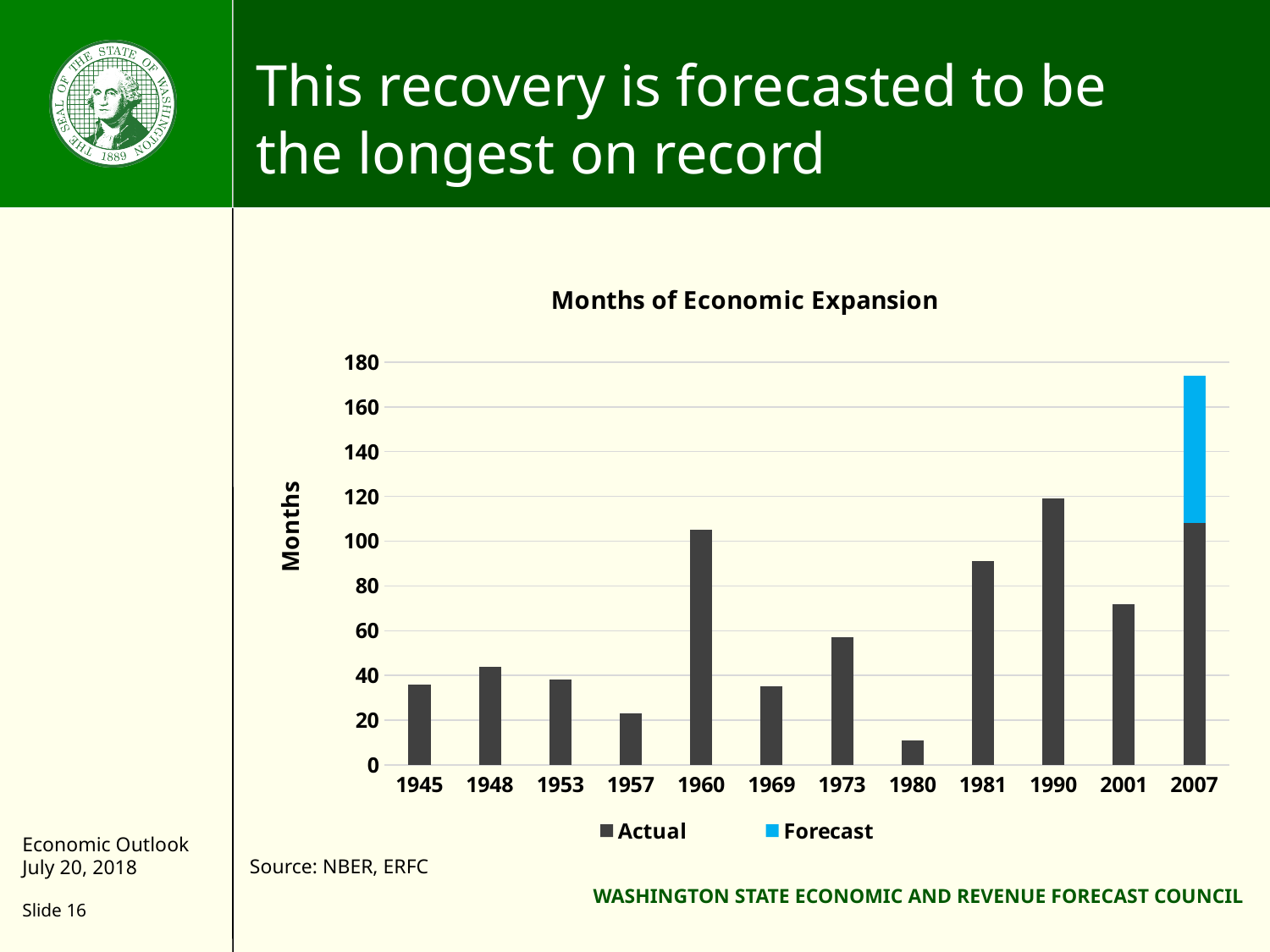
What type of chart is shown on the slide? bar chart Which expansion has the shortest bar? 1980 Is the value for 1980 greater or less than 20 months? less How many expansion start years are shown along the x axis? 12 Which expansion has the tallest bar including the forecast portion? 2007 Which is larger, the bar for 1973 or the bar for 1957? 1973 Which expansion has the tallest Actual (dark) bar? 1990 What is the title of the chart? Months of Economic Expansion Which colour represents the Forecast series in the legend? blue How many series does the legend list? 2 Is the total bar for 2007 (Actual plus Forecast) greater or less than 160 months? greater Is the value for 1960 greater or less than 100 months? greater